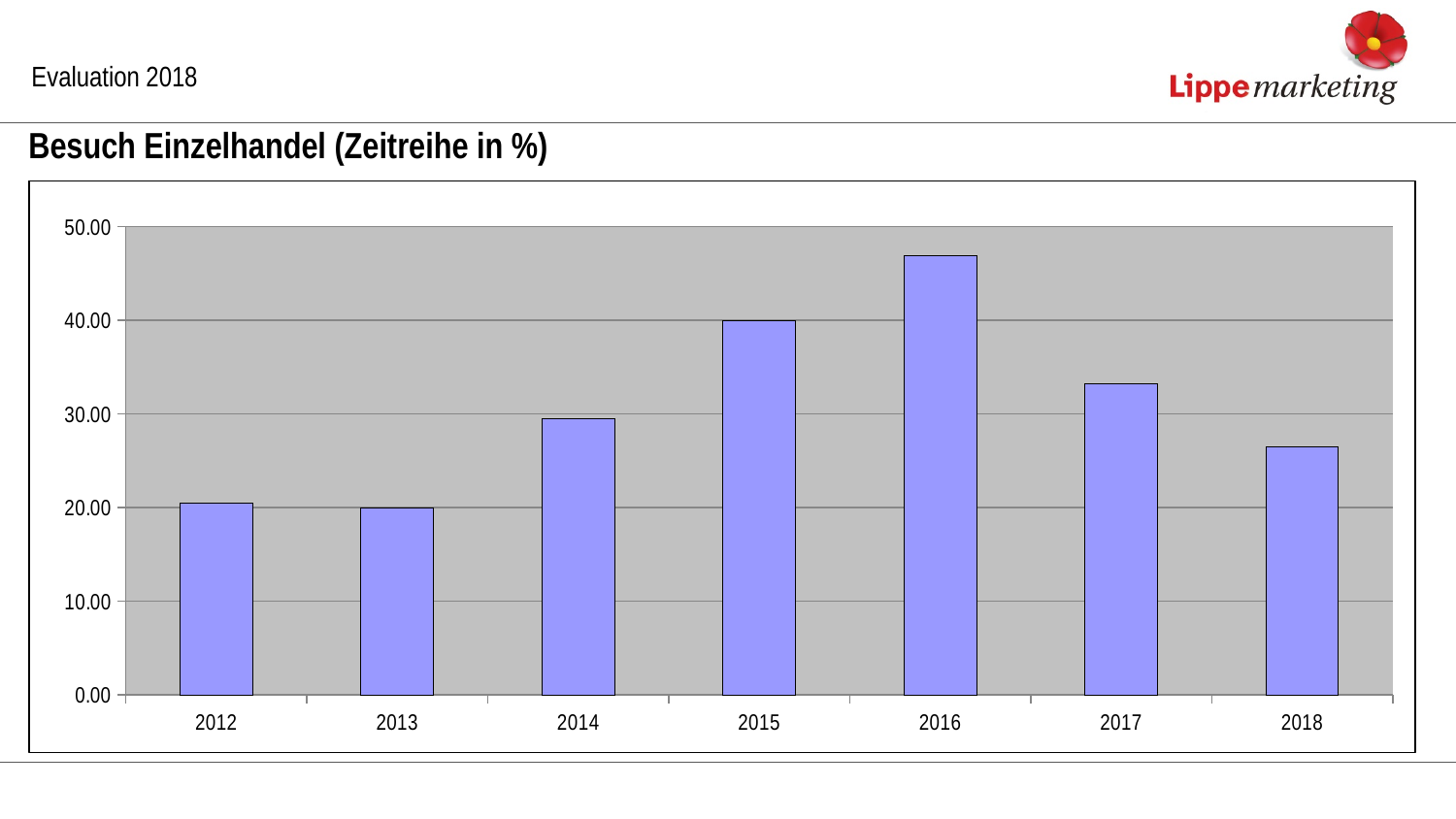
How many years are shown on the x axis of the chart? 7 What type of chart is shown on the slide? bar chart Which year has the larger value, 2014 or 2018? 2014 Do the values rise or fall from 2016 to 2018? fall Is the value for 2017 greater or less than 30.00? greater Is the value for 2016 greater or less than 40.00? greater Is the value for 2013 greater or less than 30.00? less Which year has the larger value, 2016 or 2017? 2016 Which year has the highest value in the chart? 2016 What is the title of the chart? Besuch Einzelhandel (Zeitreihe in %)